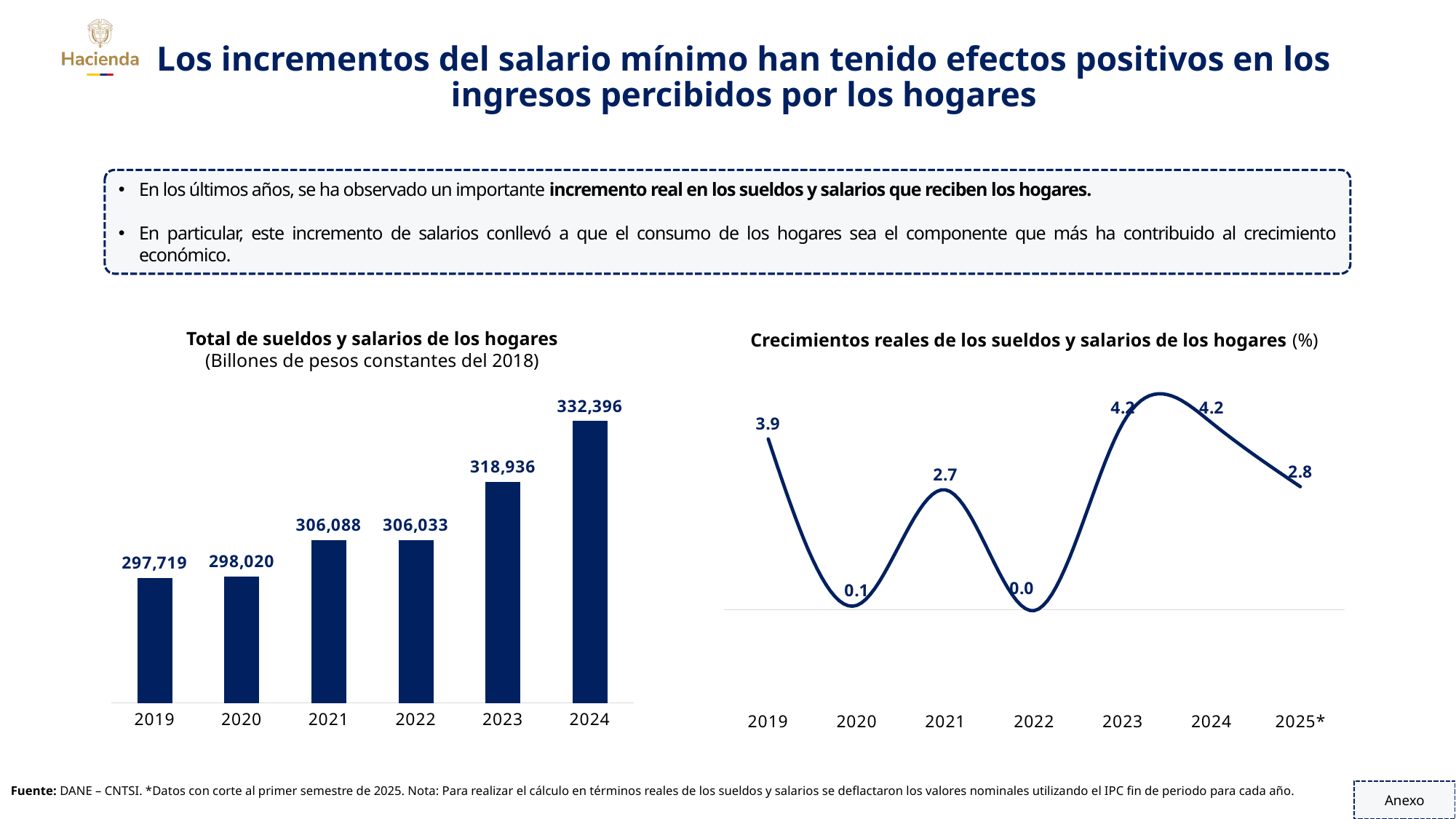
In the chart 'Total de sueldos y salarios de los hogares', what is the value for 2019? 297,719 In the chart 'Total de sueldos y salarios de los hogares', how many years are shown? 6 In the chart 'Total de sueldos y salarios de los hogares', what is the value for 2024? 332,396 In the chart 'Total de sueldos y salarios de los hogares', what is the difference between the 2024 and 2019 values? 34,677 What kind of chart is 'Total de sueldos y salarios de los hogares'? Bar chart In the chart 'Crecimientos reales de los sueldos y salarios de los hogares (%)', what is the value for 2025*? 2.8 In the chart 'Crecimientos reales de los sueldos y salarios de los hogares (%)', what is the difference between the 2019 and 2020 values? 3.8 In the chart 'Total de sueldos y salarios de los hogares', which year has the highest value? 2024 In the chart 'Crecimientos reales de los sueldos y salarios de los hogares (%)', what is the value for 2021? 2.7 In the chart 'Total de sueldos y salarios de los hogares', which year has the lowest value? 2019 In the chart 'Crecimientos reales de los sueldos y salarios de los hogares (%)', which year has the lowest value? 2022 What kind of chart is 'Crecimientos reales de los sueldos y salarios de los hogares (%)'? Line chart